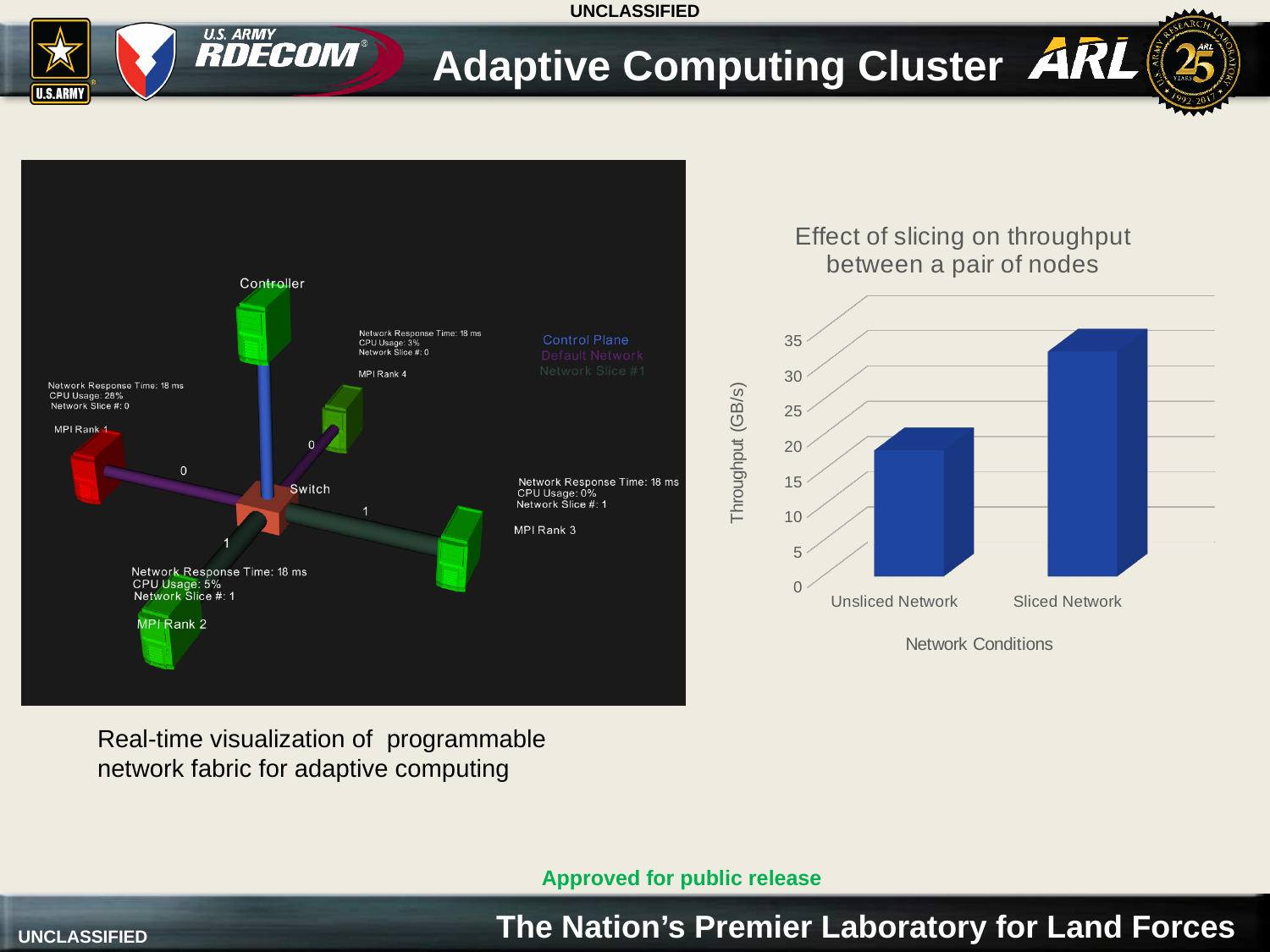
What is the title of the chart? Effect of slicing on throughput between a pair of nodes Is the throughput for Sliced Network greater or less than 35? less How many categories are plotted on the chart? 2 Which network condition has the lowest throughput? Unsliced Network Which network condition has the highest throughput? Sliced Network Is the throughput for Unsliced Network greater or less than 15? greater Which has a larger throughput, Unsliced Network or Sliced Network? Sliced Network Is the throughput for Sliced Network greater or less than 30? greater What is the label of the vertical axis of the chart? Throughput (GB/s) What kind of chart is shown on the slide? bar chart